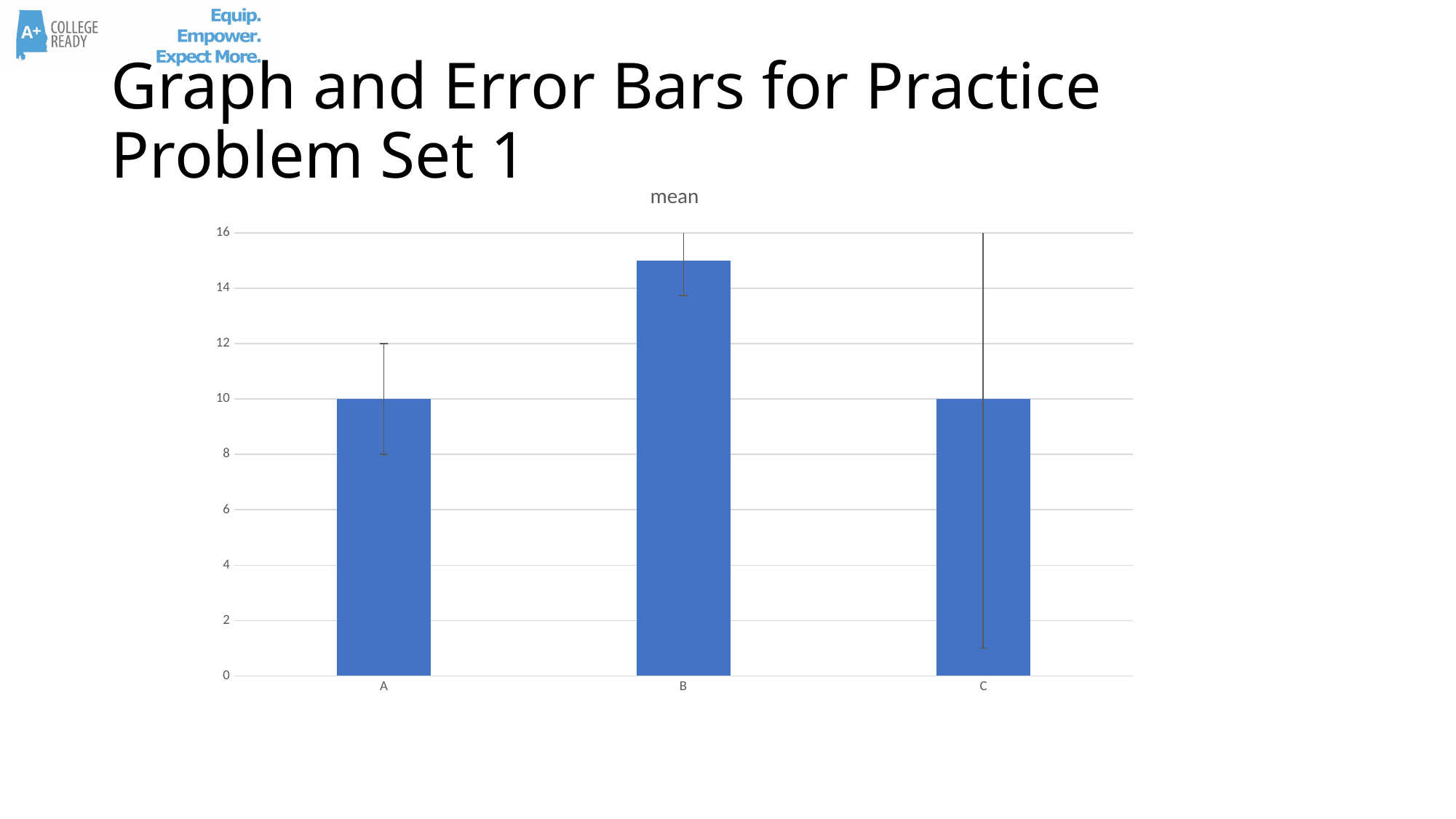
How many categories are plotted on the x axis? 3 What is the title of the chart? mean What is the difference between the values for A and C? 0 What type of chart is shown on the slide? bar chart What is the value of the bar for category C? 10 What is the highest value shown on the y axis? 16 Which category has the highest bar? B Is the value for B greater or less than 14? greater Which is larger, the value for A or the value for B? B What is the value of the bar for category A? 10 Is the value for B greater or less than 16? less Which category has the longest error bar? C